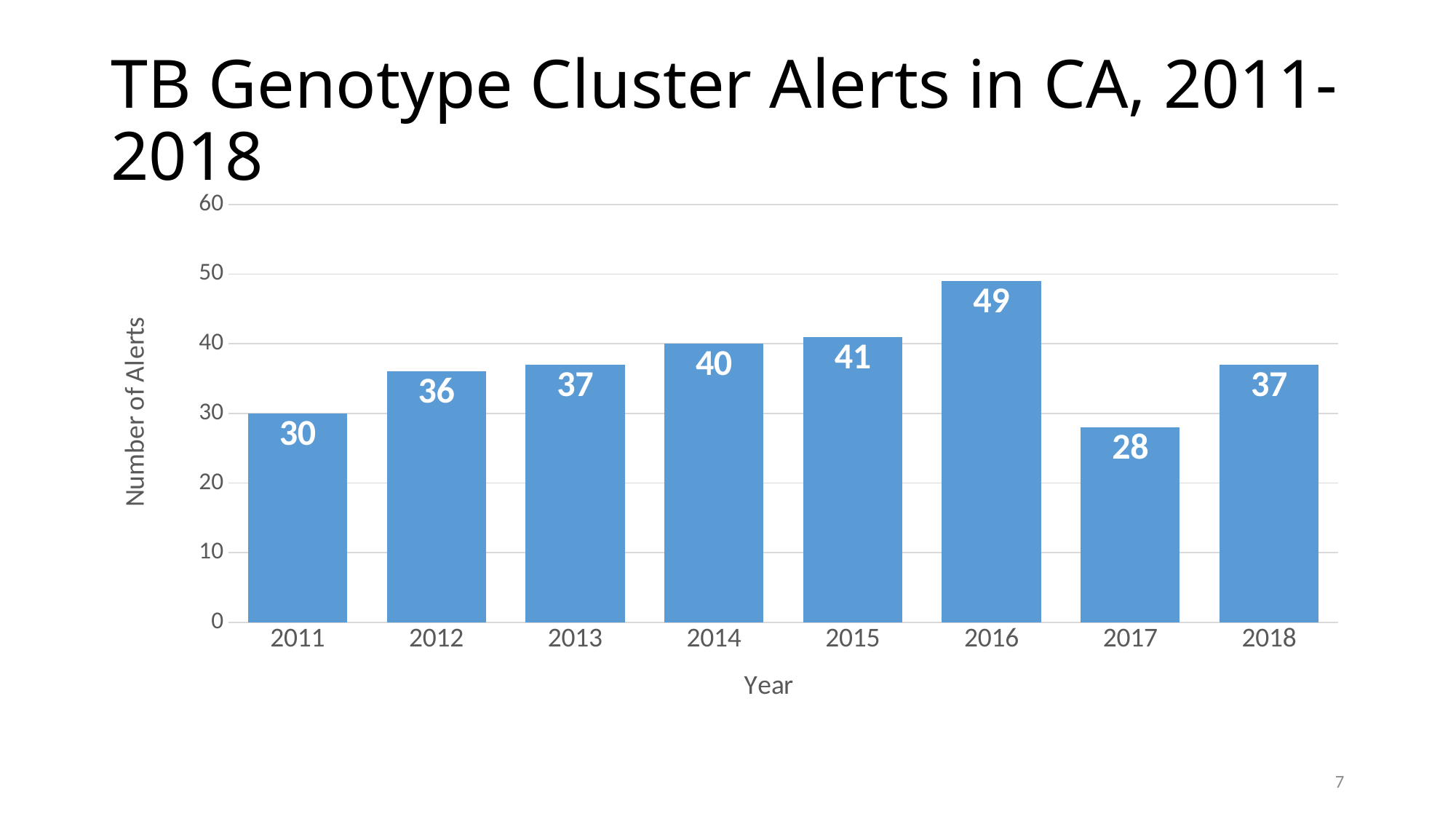
What kind of chart is shown on the slide? Bar chart Is the value for 2015 greater or less than 40? greater How many TB genotype cluster alerts were there in 2016? 49 Which year has the lowest number of alerts? 2017 What is the number of alerts shown for 2011? 30 How many years are shown on the x axis? 8 Which year has the highest number of alerts? 2016 What is the number of alerts shown for 2013? 37 What is the label of the y axis? Number of Alerts Did the number of alerts rise or fall from 2011 to 2016? Rise Which year had more alerts, 2014 or 2018? 2014 What is the difference in the number of alerts between 2016 and 2017? 21